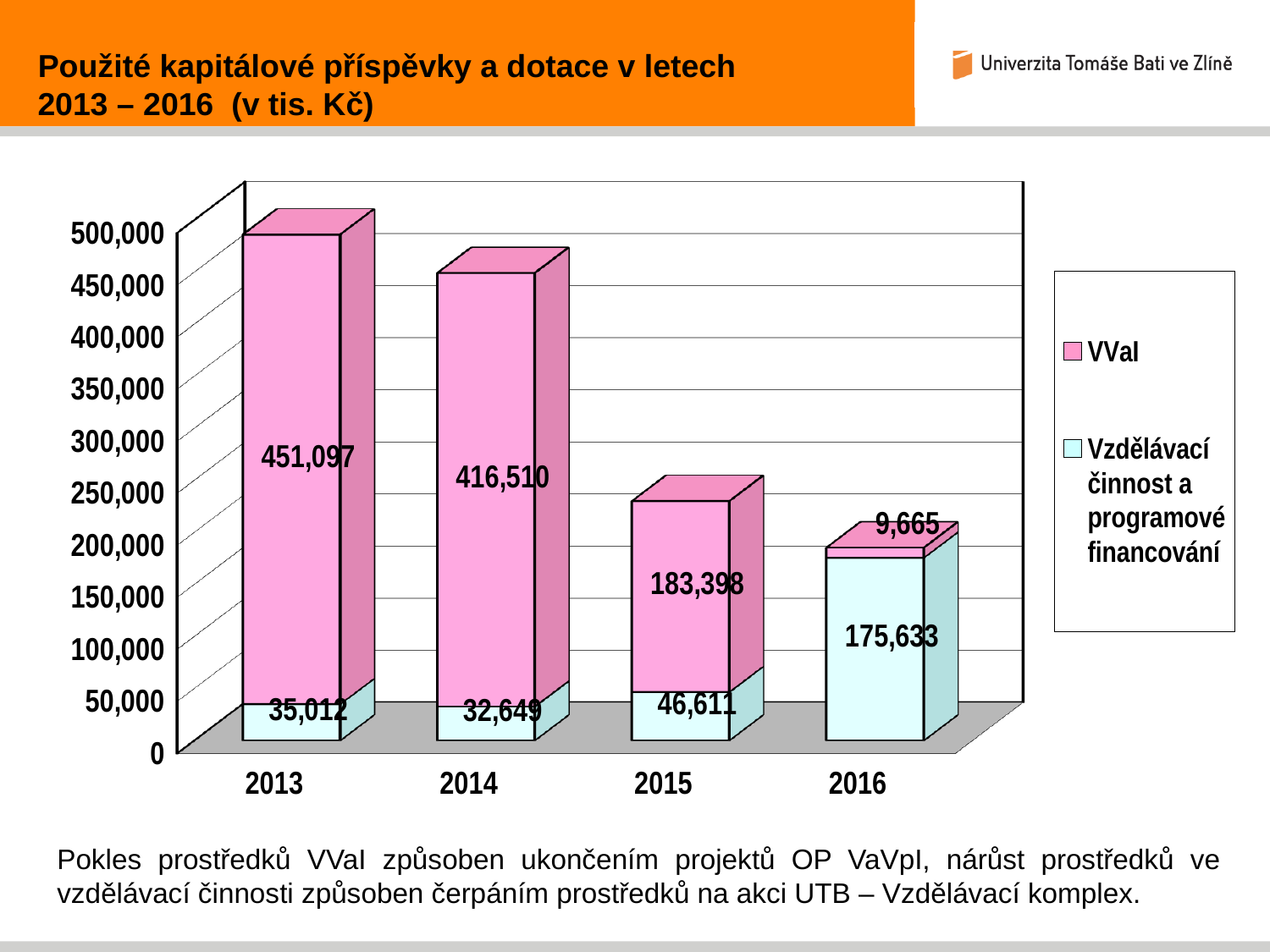
What is the VVaI value for 2015? 183,398 Which is larger: the Vzdělávací činnost a programové financování value in 2015 or in 2014? 2015 What is the total of the stacked bar for 2016? 185,298 Which year has the lowest VVaI value? 2016 Which year has the highest VVaI value? 2013 Do the VVaI values rise or fall from 2013 to 2016? Fall How many years are shown on the x axis? 4 What is the value for Vzdělávací činnost a programové financování in 2016? 175,633 How many series does the legend list? 2 What is the difference between the VVaI values for 2013 and 2014? 34,587 What kind of chart is shown on the slide? Stacked bar chart What is the VVaI value for 2013? 451,097